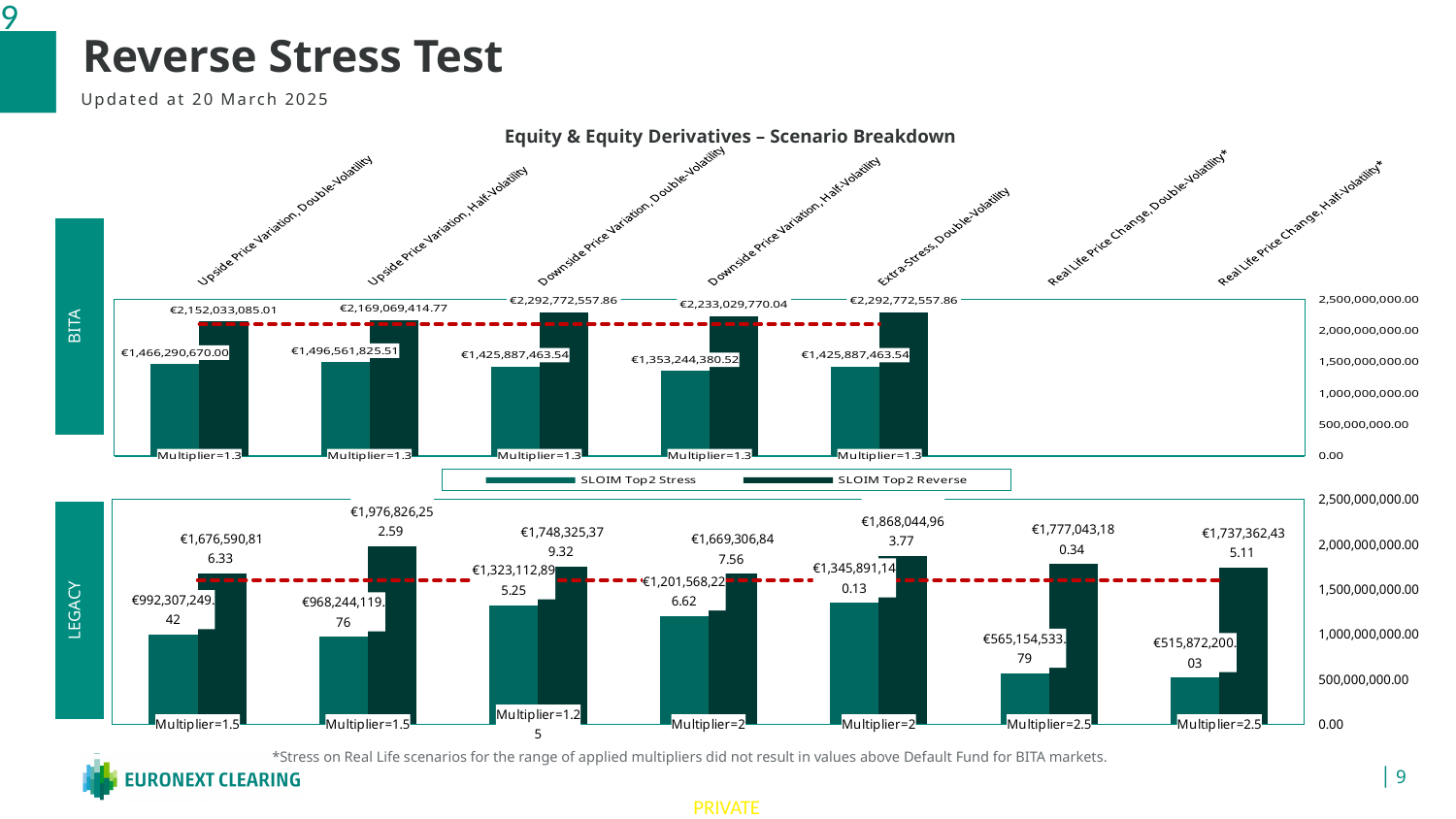
On the BITA chart, what multiplier is shown under each scenario? Multiplier=1.3 On the LEGACY chart, what multiplier is shown under Real Life Price Change, Double-Volatility*? Multiplier=2.5 On the LEGACY chart, which scenario has the highest SLOIM Top2 Reverse value? Upside Price Variation, Half-Volatility What type of chart is used for the LEGACY panel? Bar chart On the BITA chart, what is the difference between the SLOIM Top2 Reverse and SLOIM Top2 Stress values for Upside Price Variation, Half-Volatility? €672,507,589.26 On the BITA chart, what is the SLOIM Top2 Stress value for Upside Price Variation, Double-Volatility? €1,466,290,670.00 On the LEGACY chart, is the SLOIM Top2 Stress value for Upside Price Variation, Double-Volatility greater or less than 1,000,000,000.00? less On the BITA chart, which scenario has the lowest SLOIM Top2 Stress value? Downside Price Variation, Half-Volatility How many series does the legend list? 2 On the LEGACY chart, what is the SLOIM Top2 Stress value for Real Life Price Change, Half-Volatility*? €515,872,200.03 On the LEGACY chart, what is the SLOIM Top2 Stress value for Real Life Price Change, Double-Volatility*? €565,154,533.79 On the BITA chart, what is the SLOIM Top2 Reverse value for Downside Price Variation, Half-Volatility? €2,233,029,770.04